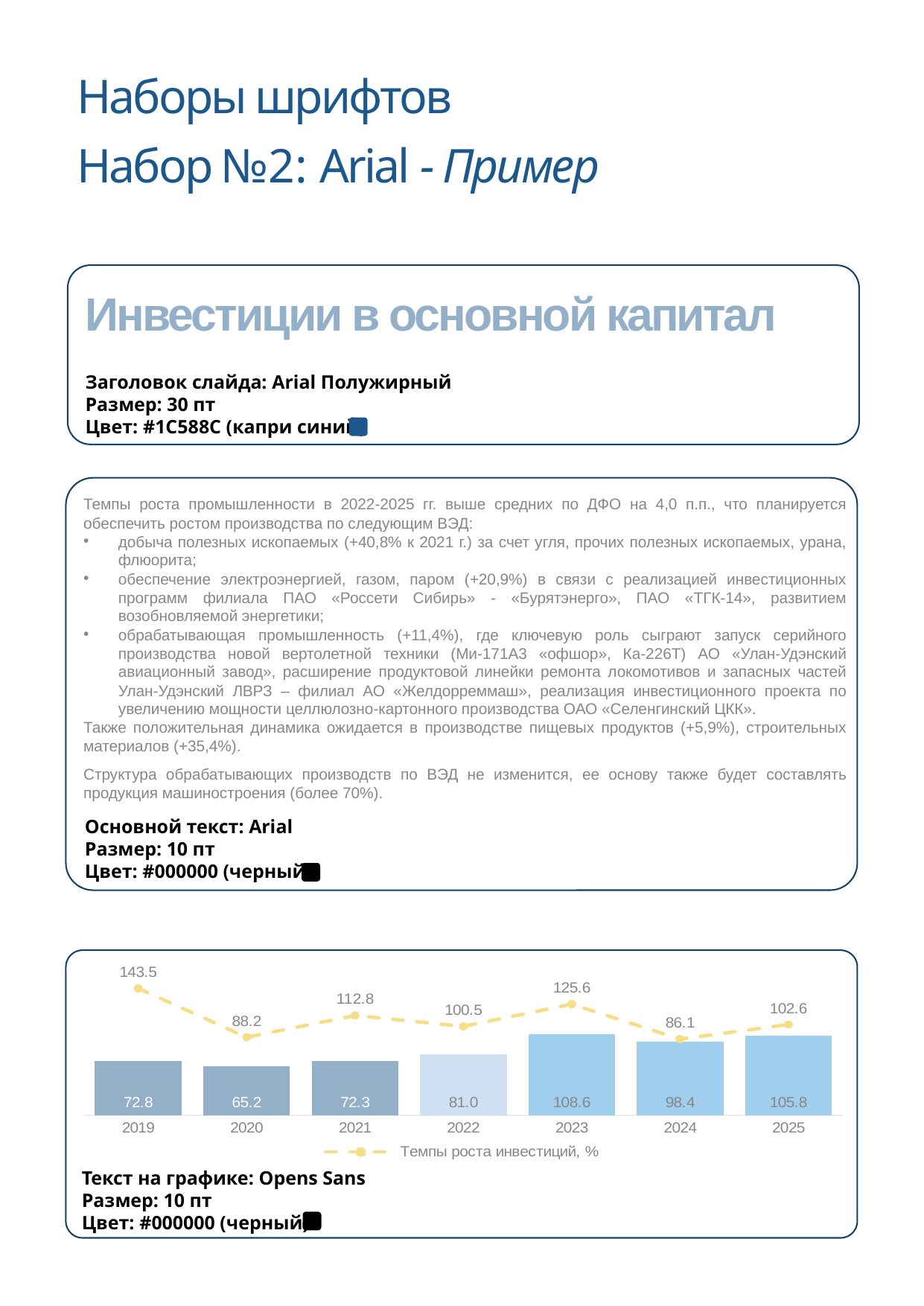
Do the bar values rise or fall from 2021 to 2023? rise What is the value of the bar for 2023? 108.6 What is the value of the 'Темпы роста инвестиций, %' line for 2019? 143.5 What series name does the chart legend show? Темпы роста инвестиций, % Which year has the lowest bar value? 2020 What is the value of the 'Темпы роста инвестиций, %' line for 2024? 86.1 Which year has the lowest value on the 'Темпы роста инвестиций, %' line? 2024 Which is larger: the bar value for 2024 or the bar value for 2025? 2025 What is the difference between the bar values for 2023 and 2022? 27.6 How many years are shown on the x axis of the chart? 7 Which year has the highest bar value? 2023 What is the value of the bar for 2020? 65.2